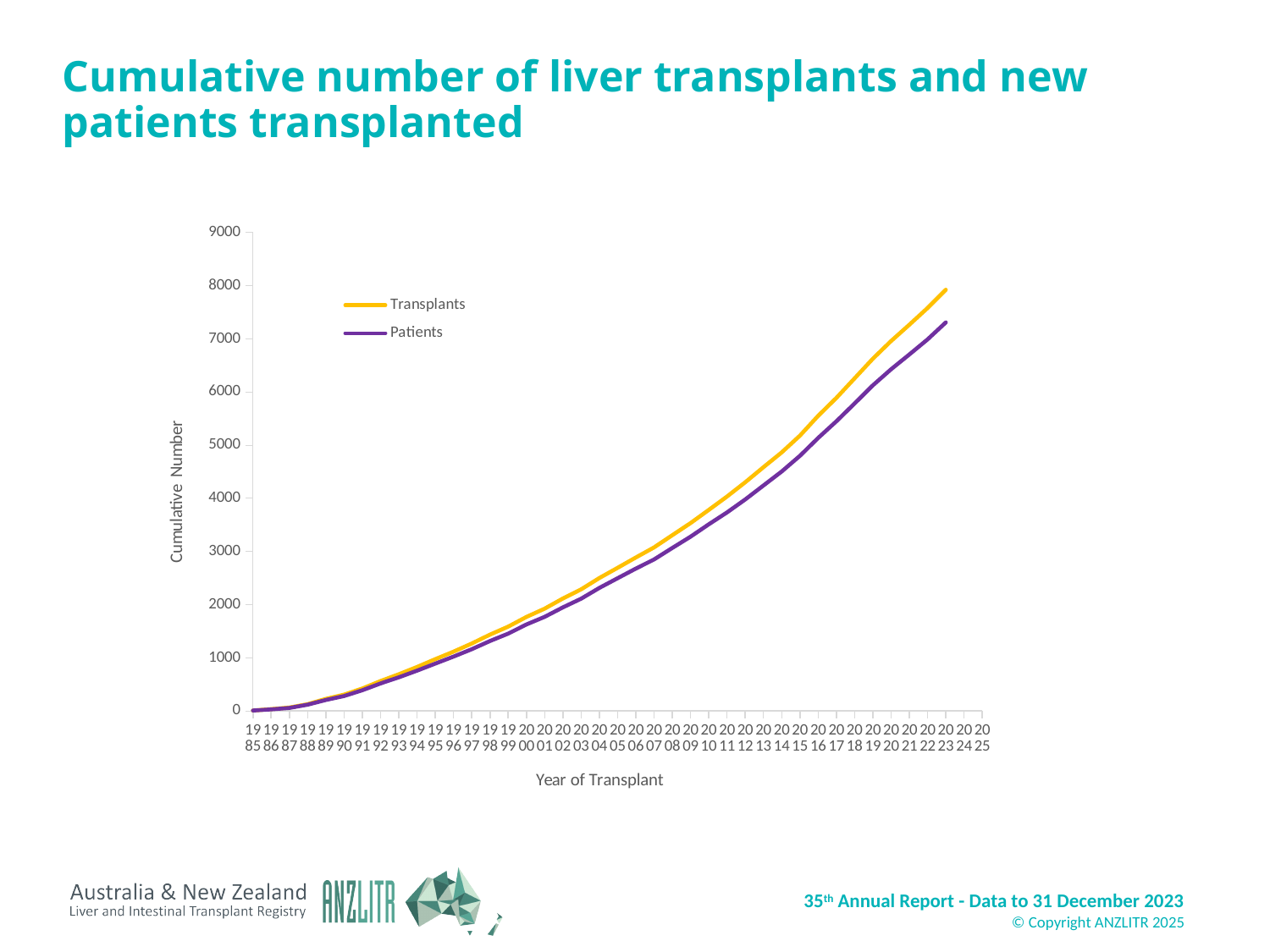
How many series does the legend list? 2 What are the two series named in the legend? Transplants and Patients In 2023, which series has the larger value, Transplants or Patients? Transplants Is the Patients value for 2023 greater or less than 8000? less Is the Transplants value for 2023 greater or less than 7000? greater Is the Transplants value for 2010 greater or less than 3000? greater What is the label of the y axis? Cumulative Number Do the Transplants values rise or fall from 1985 to 2023? rise What kind of chart is shown on the slide? line chart Do the Patients values rise or fall along the x axis? rise